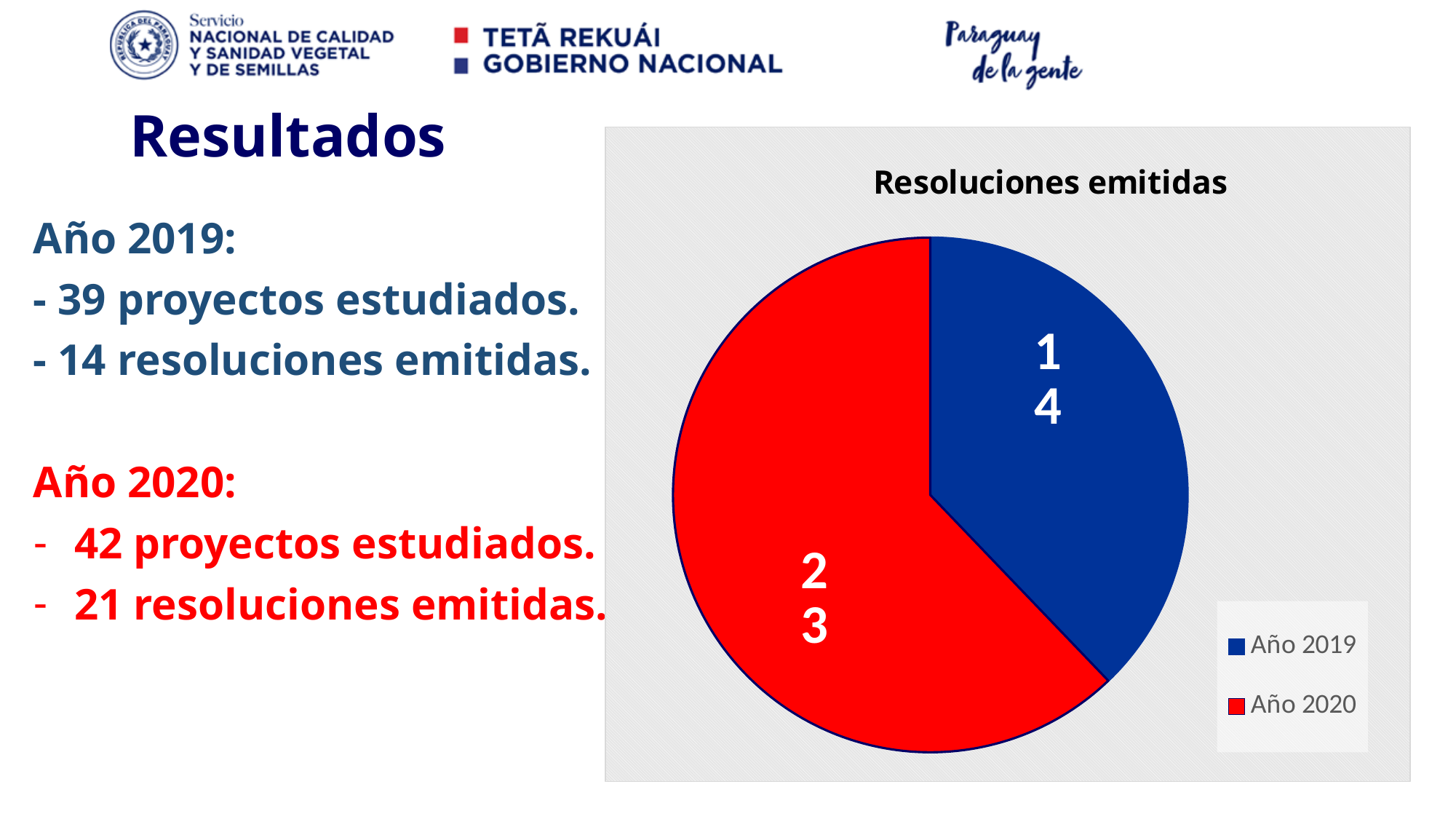
What colour is the slice for Año 2020 in the pie chart? red In the chart, what is the value for Año 2020? 23 Which category has the smallest slice in the pie chart? Año 2019 In the chart, what is the value for Año 2019? 14 How many entries does the chart legend list? 2 Which category has the largest slice in the pie chart? Año 2020 How many slices does the pie chart have? 2 What is the difference between the values for Año 2020 and Año 2019 in the chart? 9 Which is larger in the chart, the value for Año 2019 or Año 2020? Año 2020 What type of chart is shown on the slide? pie chart What is the total of the two values shown in the pie chart? 37 What is the title of the chart? Resoluciones emitidas